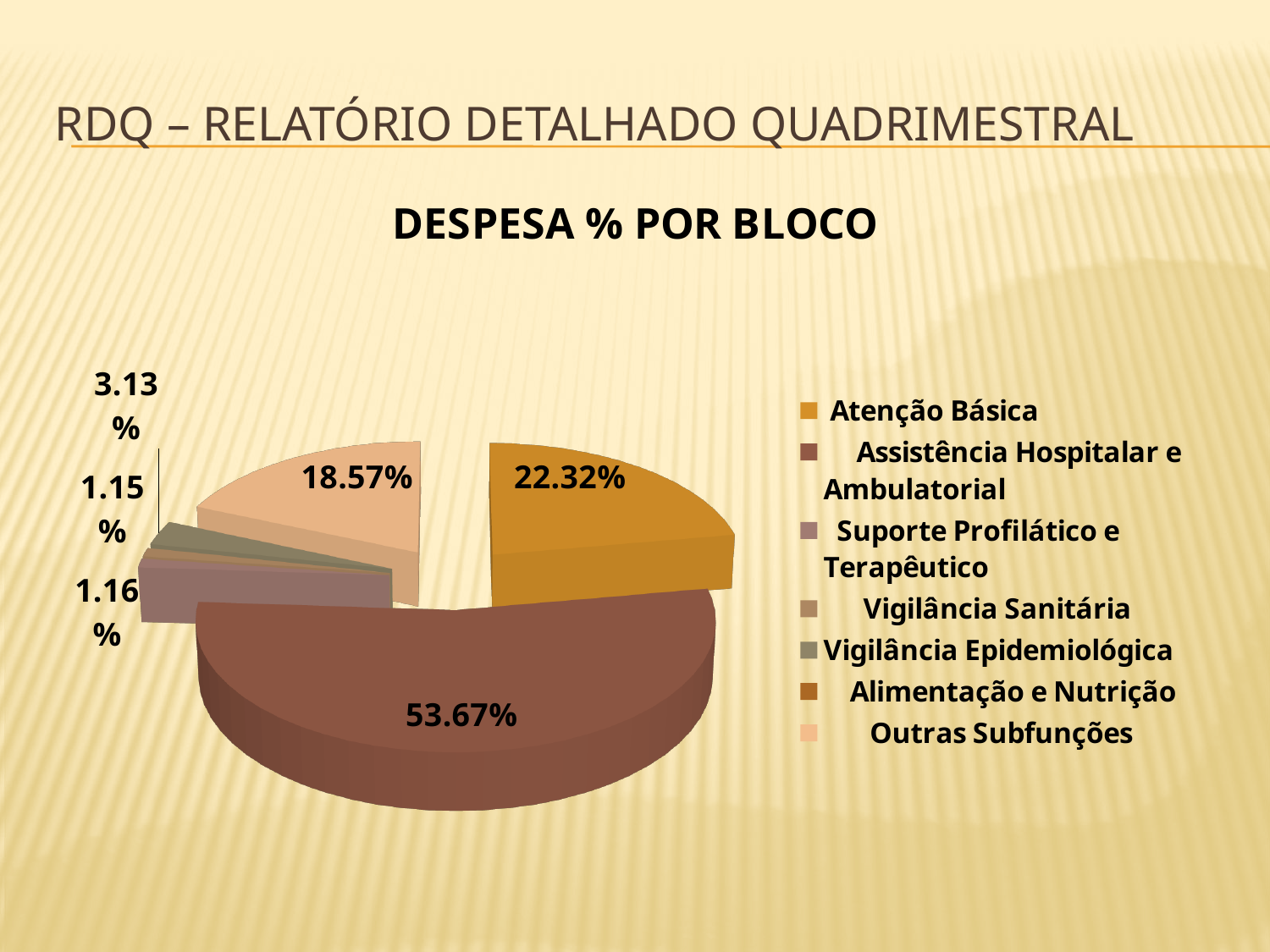
How many categories does the legend list? 7 Is the share for Assistência Hospitalar e Ambulatorial greater or less than 50%? greater What percentage is shown for Assistência Hospitalar e Ambulatorial? 53.67% What is the combined share of Atenção Básica and Assistência Hospitalar e Ambulatorial? 75.99% Which category has the largest share of the pie? Assistência Hospitalar e Ambulatorial What is the difference in percentage points between Atenção Básica and Outras Subfunções? 3.75 What percentage is shown for Atenção Básica? 22.32% What kind of chart is shown on the slide? pie chart What is the title of the chart? DESPESA % POR BLOCO Which is larger, the share for Atenção Básica or the share for Outras Subfunções? Atenção Básica What is the difference in percentage points between Assistência Hospitalar e Ambulatorial and Atenção Básica? 31.35 What percentage is shown for Outras Subfunções? 18.57%